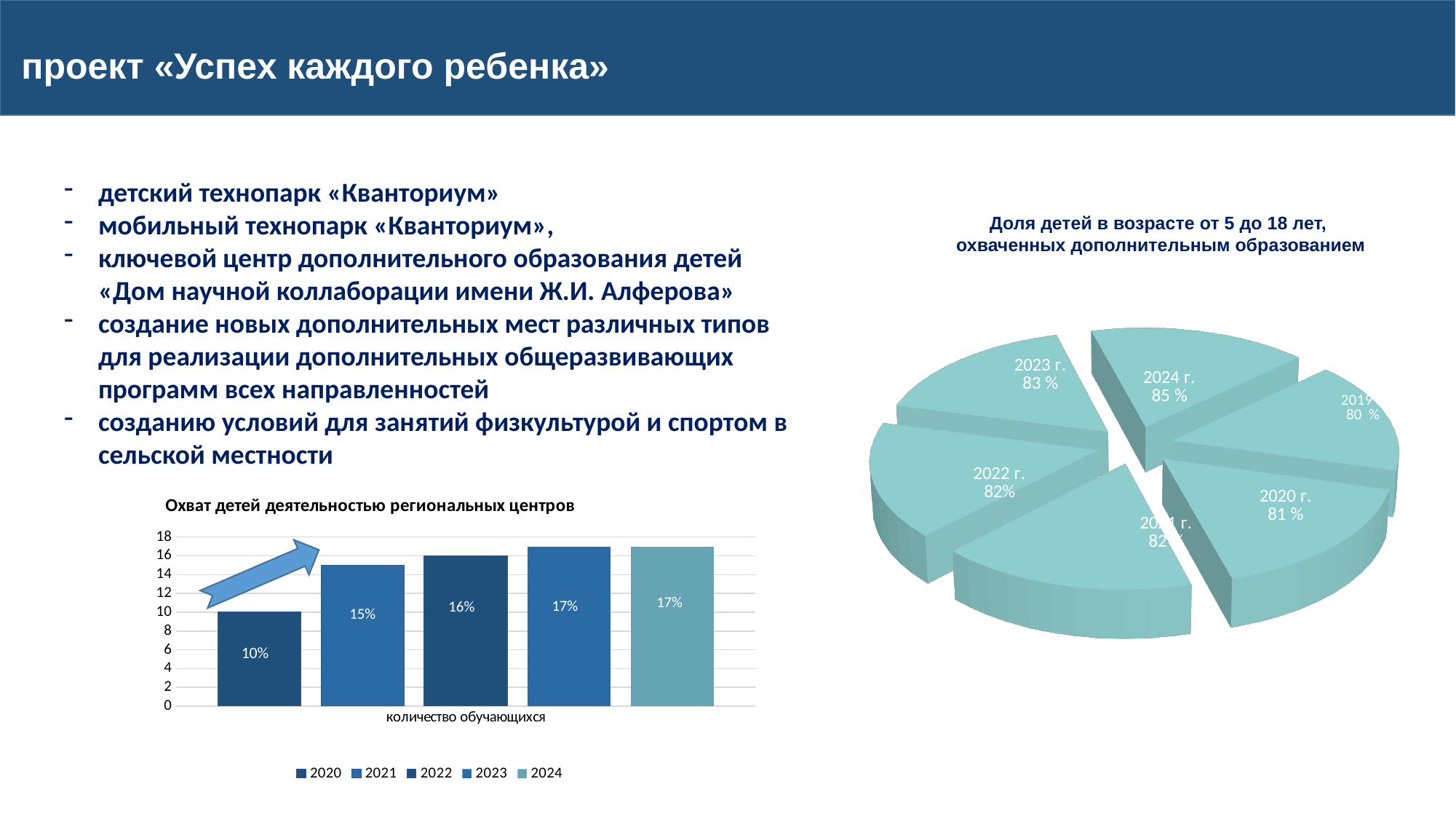
In the chart 'Охват детей деятельностью региональных центров', what is the value for 2022? 16% In the pie chart 'Доля детей в возрасте от 5 до 18 лет, охваченных дополнительным образованием', what is the value for 2023 г.? 83 % In the pie chart 'Доля детей в возрасте от 5 до 18 лет, охваченных дополнительным образованием', what is the value for 2024 г.? 85 % In the chart 'Охват детей деятельностью региональных центров', what is the difference between the values for 2021 and 2020? 5% What kind of chart is 'Доля детей в возрасте от 5 до 18 лет, охваченных дополнительным образованием'? Pie chart In the chart 'Охват детей деятельностью региональных центров', which year has the lowest value? 2020 What kind of chart is 'Охват детей деятельностью региональных центров'? Bar chart In the chart 'Охват детей деятельностью региональных центров', do the values rise or fall from 2020 to 2023? Rise In the pie chart 'Доля детей в возрасте от 5 до 18 лет, охваченных дополнительным образованием', which year has the highest value? 2024 г. How many series does the legend of the chart 'Охват детей деятельностью региональных центров' list? 5 In the chart 'Охват детей деятельностью региональных центров', what is the value for 2020? 10% In the chart 'Охват детей деятельностью региональных центров', which is larger, the value for 2021 or the value for 2022? 2022